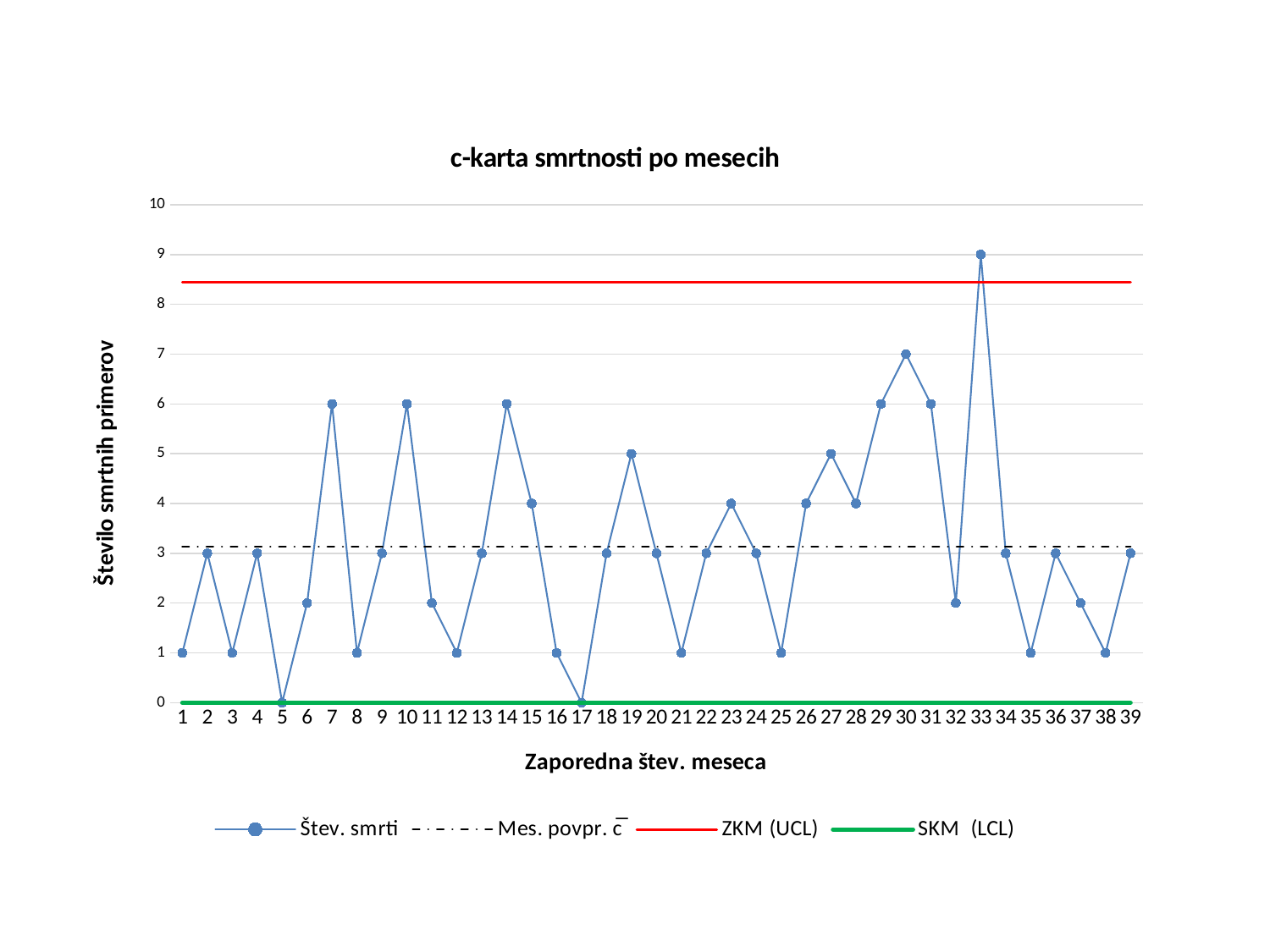
How many series does the legend list? 4 Which is larger, the Štev. smrti value for month 7 or for month 19? month 7 What is the value of Štev. smrti for month 5? 0 What is the value of Štev. smrti for month 33? 9 Which month has the highest number of deaths (Štev. smrti)? 33 What is the difference between the Štev. smrti values for month 33 and month 30? 2 Is the Mes. povpr. c̄ line greater or less than 3? greater What is the title of the chart? c-karta smrtnosti po mesecih What type of chart is shown on the slide? line chart Is the ZKM (UCL) line greater or less than 8? greater How many months are plotted on the x axis? 39 What is the value of Štev. smrti for month 30? 7